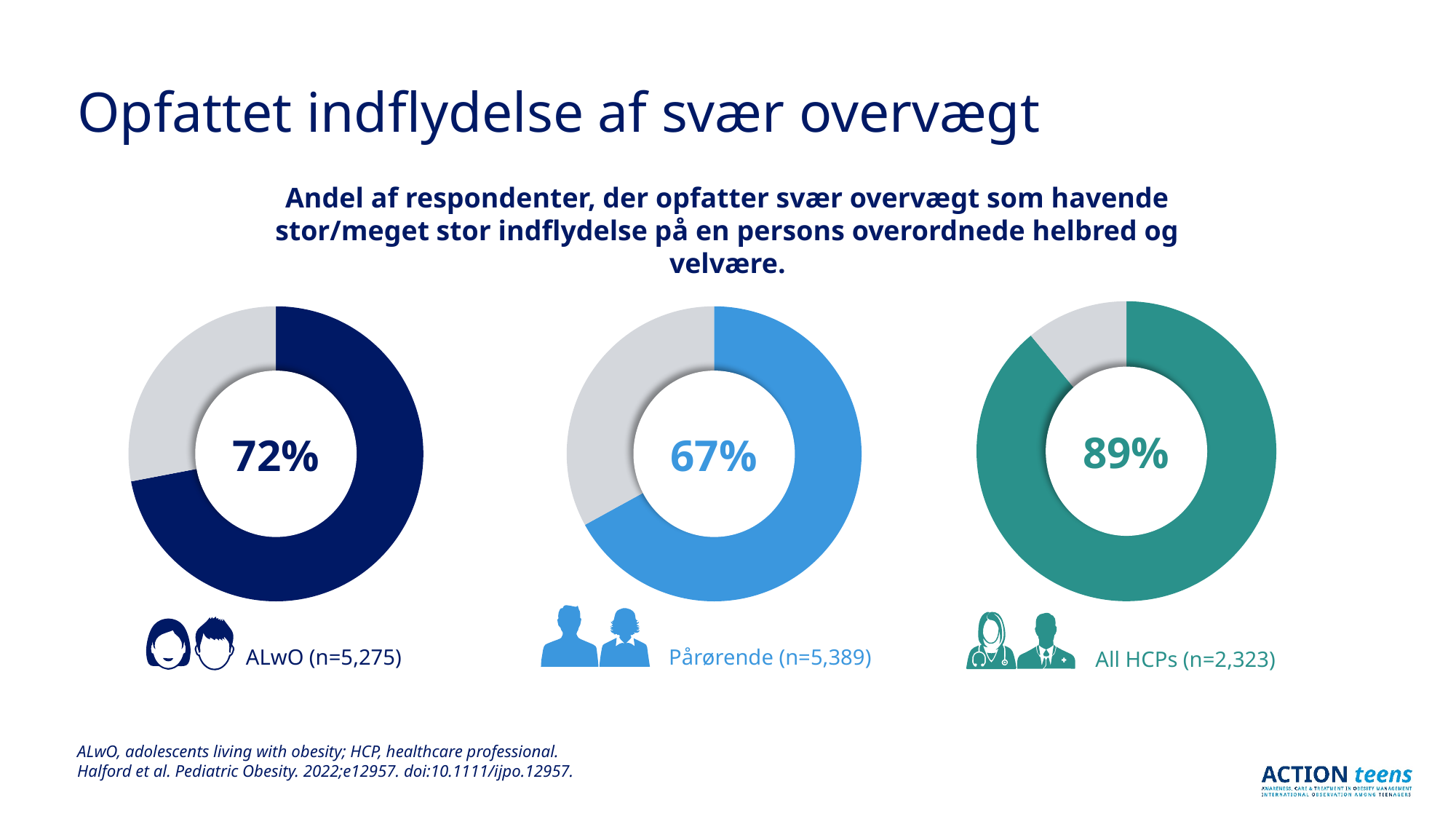
What is the sample size (n) shown for the Pårørende group? 5,389 What is the difference in percentage points between the All HCPs chart and the ALwO chart? 17 Which respondent group has the highest percentage across the three donut charts? All HCPs (n=2,323) How many donut charts are shown on the slide? 3 What type of chart is used to display the percentages on the slide? Donut chart Which is larger, the percentage for ALwO or the percentage for Pårørende? ALwO Which respondent group has the lowest percentage across the three donut charts? Pårørende (n=5,389) What percentage is shown in the ALwO (n=5,275) donut chart? 72% What is the difference in percentage points between the ALwO chart and the Pårørende chart? 5 What percentage is shown in the Pårørende (n=5,389) donut chart? 67% What percentage is shown in the All HCPs (n=2,323) donut chart? 89% What colour is the filled portion of the All HCPs donut chart? Teal